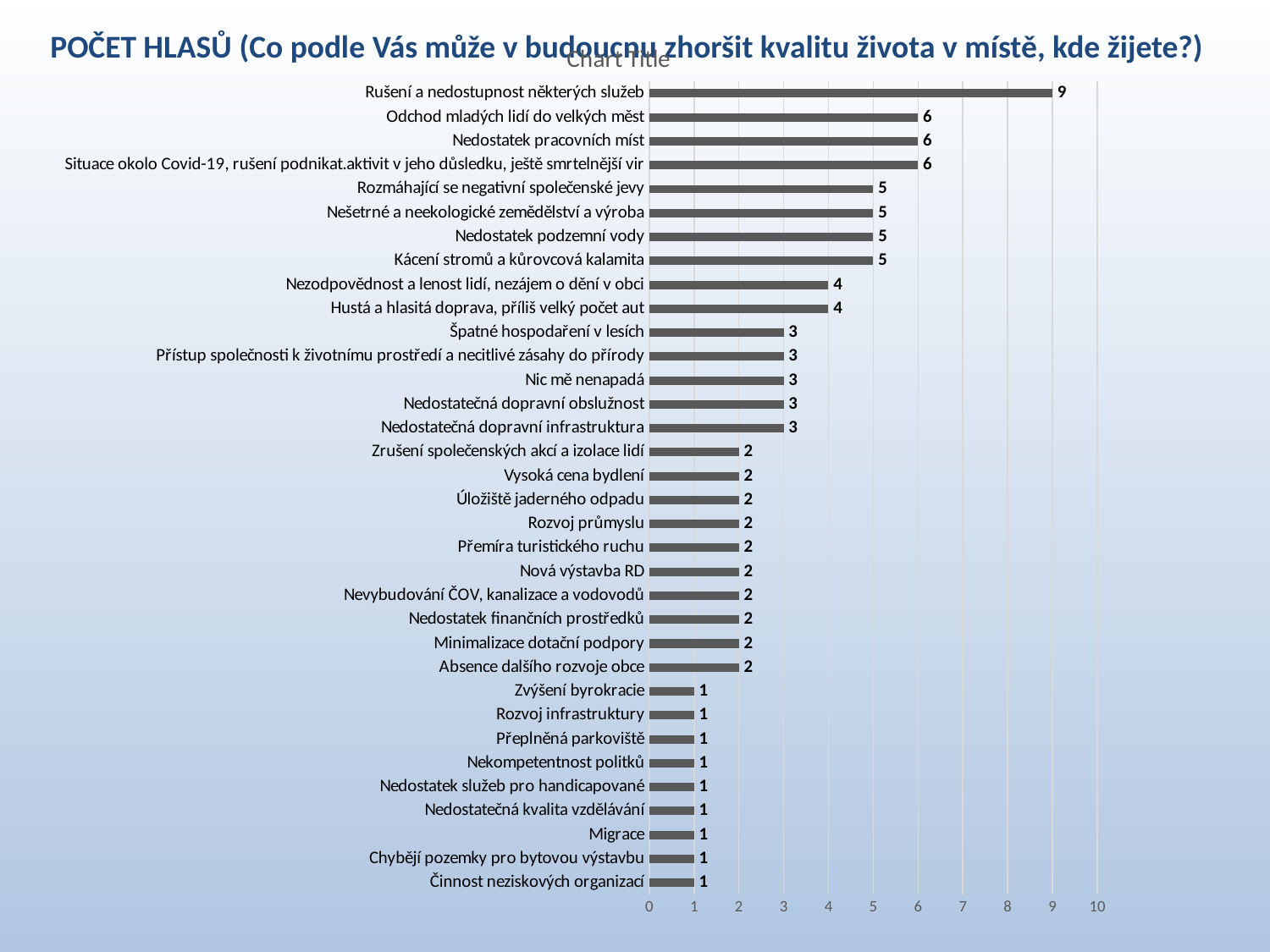
What is the value for 'Nic mě nenapadá'? 3 Which is larger, the value for 'Kácení stromů a kůrovcová kalamita' or the value for 'Vysoká cena bydlení'? Kácení stromů a kůrovcová kalamita What is the value for 'Hustá a hlasitá doprava, příliš velký počet aut'? 4 What is the title shown above the chart area? Chart Title What is the value for 'Odchod mladých lidí do velkých měst'? 6 How many categories are plotted in the chart? 34 What is the value for 'Nedostatek podzemní vody'? 5 How many votes does 'Rušení a nedostupnost některých služeb' have? 9 What type of chart is shown on the slide? bar chart What is the value for 'Migrace'? 1 Which category has the highest number of votes? Rušení a nedostupnost některých služeb What is the difference between the values for 'Rušení a nedostupnost některých služeb' and 'Nedostatek pracovních míst'? 3